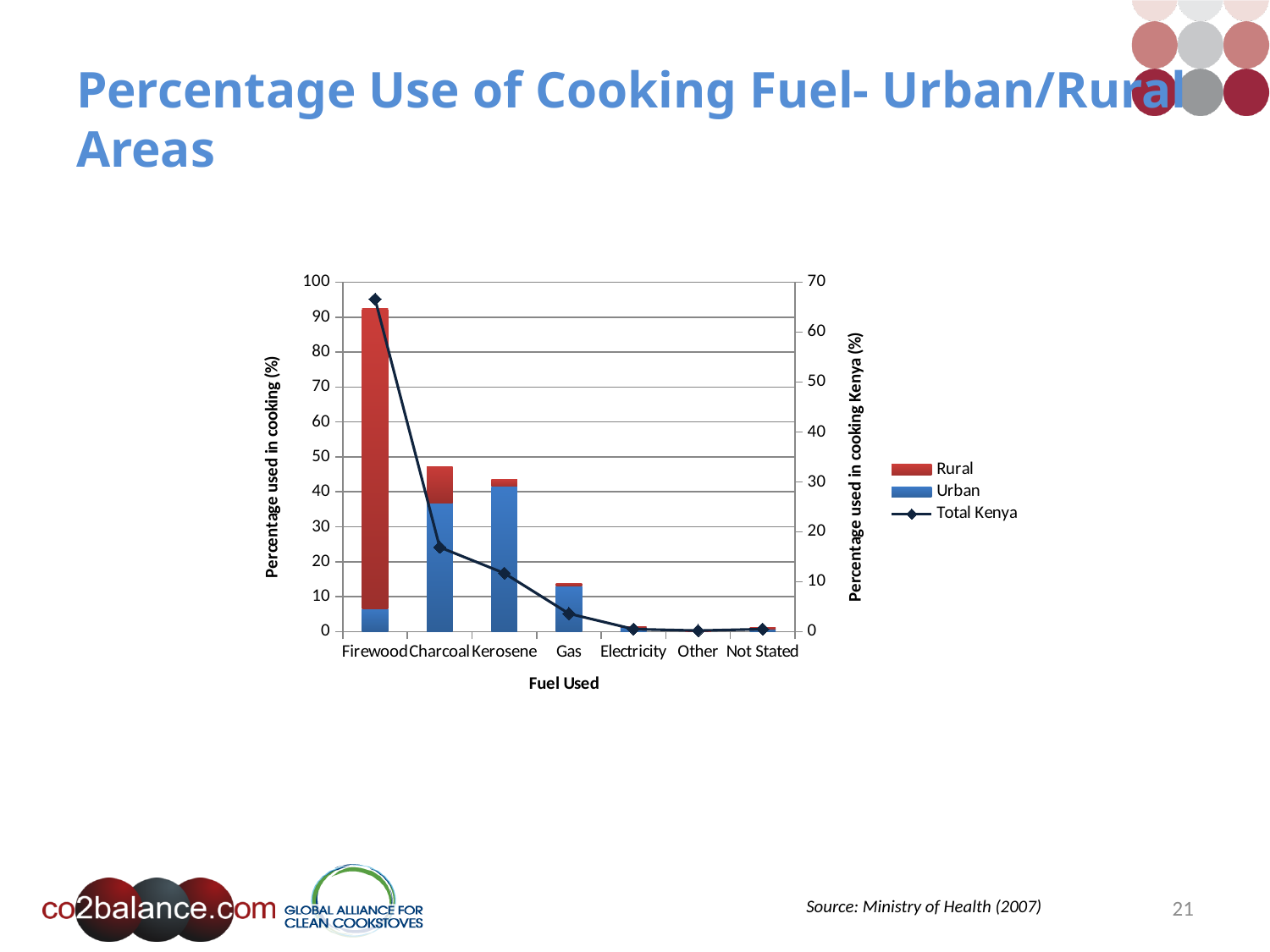
How many fuel categories are shown on the x axis of the chart? 7 Do the Total Kenya values generally rise or fall moving from Firewood to Not Stated along the x axis? fall Is the total stacked bar for Firewood greater or less than 80? greater Which has the larger stacked bar, Charcoal or Gas? Charcoal Which fuel has the tallest stacked bar in the chart? Firewood How many series does the chart's legend list? 3 Is the Total Kenya value for Firewood on the right axis greater or less than 60? greater Is the Total Kenya value for Charcoal on the right axis greater or less than 20? less Which series in the legend is drawn as a line with diamond markers? Total Kenya Which fuel has the lowest stacked bar in the chart? Other